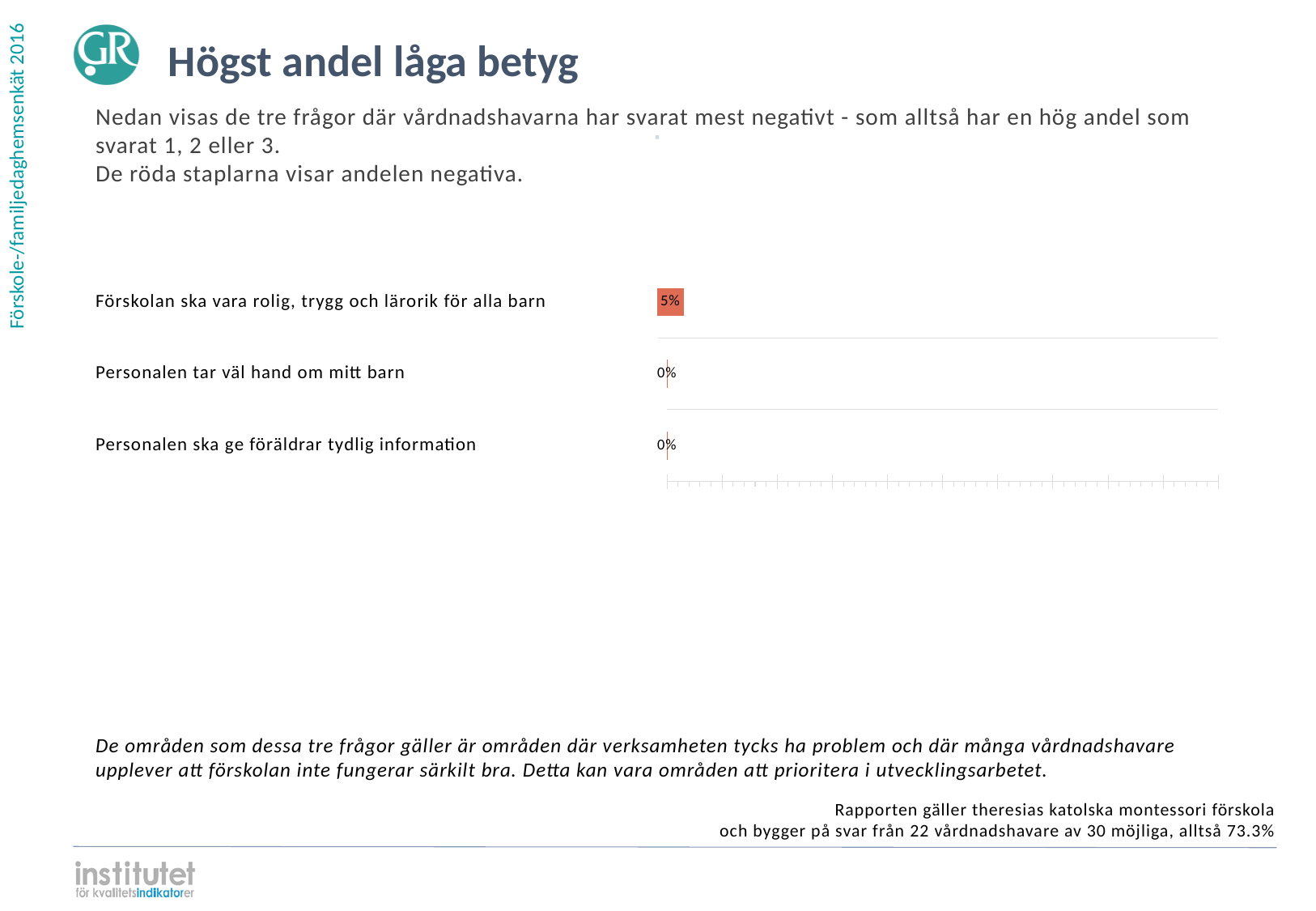
Which is larger: the value for "Förskolan ska vara rolig, trygg och lärorik för alla barn" or the value for "Personalen ska ge föräldrar tydlig information"? Förskolan ska vara rolig, trygg och lärorik för alla barn What is the title of the slide containing the chart? Högst andel låga betyg What colour are the bars in the chart? Red What is the difference between the value for "Förskolan ska vara rolig, trygg och lärorik för alla barn" and the value for "Personalen tar väl hand om mitt barn"? 5% What is the value for "Personalen tar väl hand om mitt barn"? 0% What is the value for "Personalen ska ge föräldrar tydlig information"? 0% What is the value for "Förskolan ska vara rolig, trygg och lärorik för alla barn"? 5% Which category has the highest share of negative answers? Förskolan ska vara rolig, trygg och lärorik för alla barn How many categories are shown in the chart? 3 How many categories have a value of 0%? 2 What kind of chart is shown on the slide? Bar chart